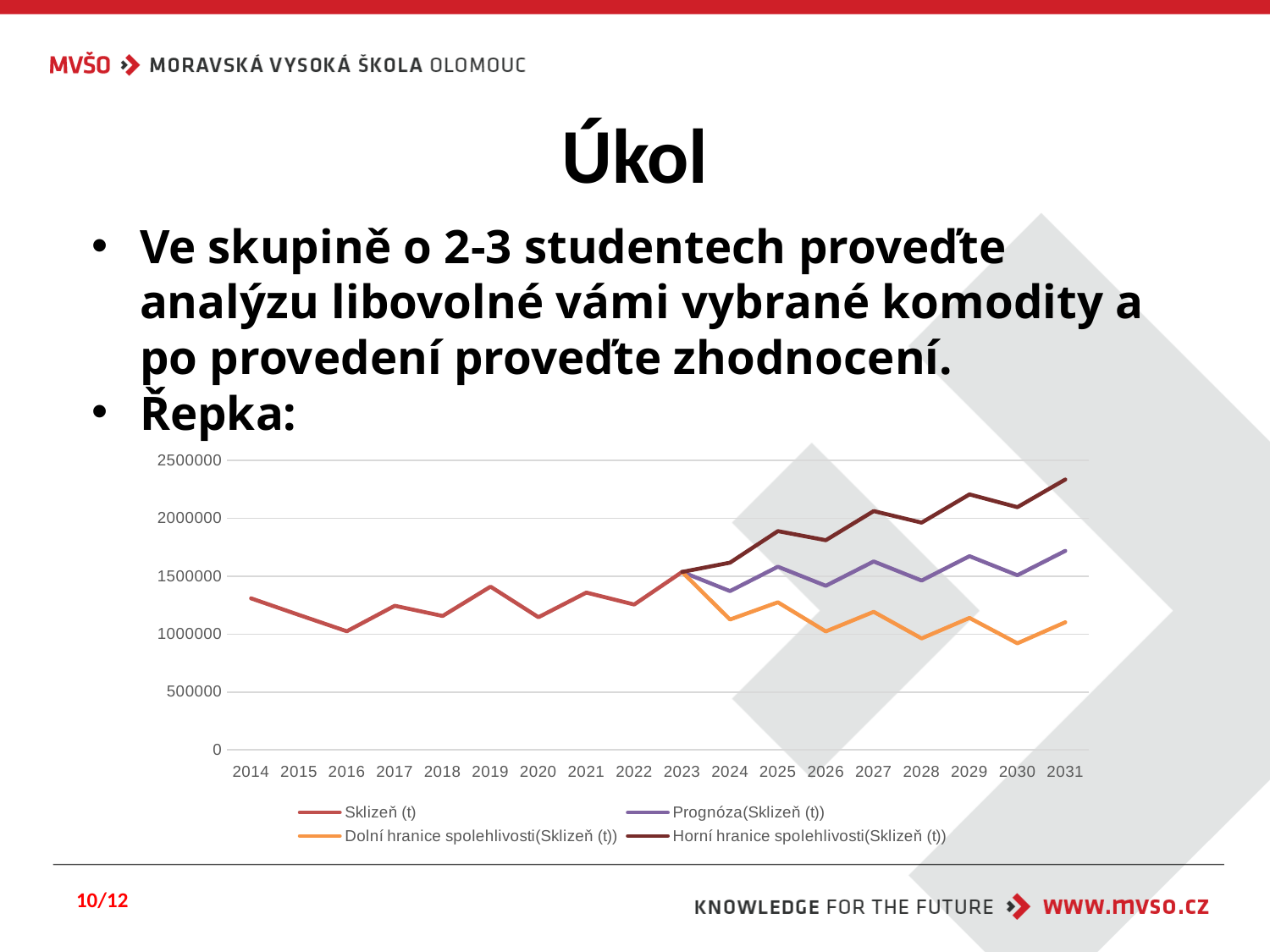
In which year does the Sklizeň (t) series reach its lowest value? 2016 Is the value of Prognóza(Sklizeň (t)) in 2031 greater or less than 2000000? less What is the first year shown on the x axis of the chart? 2014 Which series is plotted in orange in the chart? Dolní hranice spolehlivosti(Sklizeň (t)) What kind of chart is shown on the slide? line chart Is the value of Sklizeň (t) in 2019 greater or less than 1500000? less Is the value of Dolní hranice spolehlivosti(Sklizeň (t)) in 2030 greater or less than 1000000? less How many series does the chart legend list? 4 Does the Horní hranice spolehlivosti(Sklizeň (t)) series generally rise or fall from 2023 to 2031? rise How many years are shown on the x axis of the chart? 18 Which series has the highest value in 2031? Horní hranice spolehlivosti(Sklizeň (t))